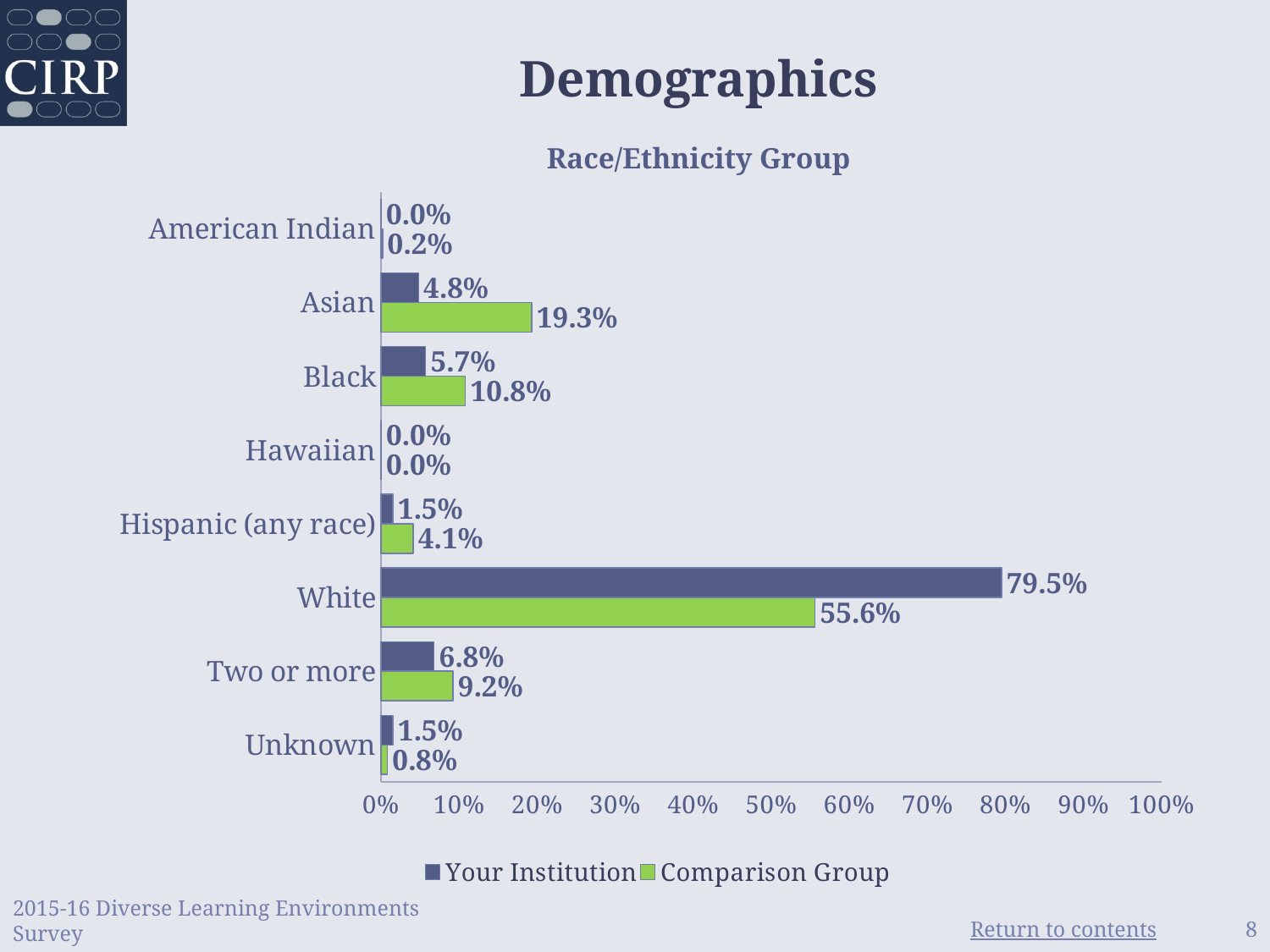
What is the difference between the Your Institution and Comparison Group values for White? 23.9% What kind of chart is shown on the slide? Bar chart What is the title of the chart? Race/Ethnicity Group How many series does the legend list? 2 What is the difference between the Comparison Group and Your Institution values for Asian? 14.5% How many race/ethnicity groups are shown on the chart? 8 Which is larger for Black: the Your Institution value or the Comparison Group value? Comparison Group What is the value for Two or more in the Your Institution series? 6.8% Which race/ethnicity group has the highest value in the Comparison Group series? White What is the value for White in the Your Institution series? 79.5% Is the Your Institution value for White greater or less than 70%? greater What is the value for Asian in the Comparison Group series? 19.3%